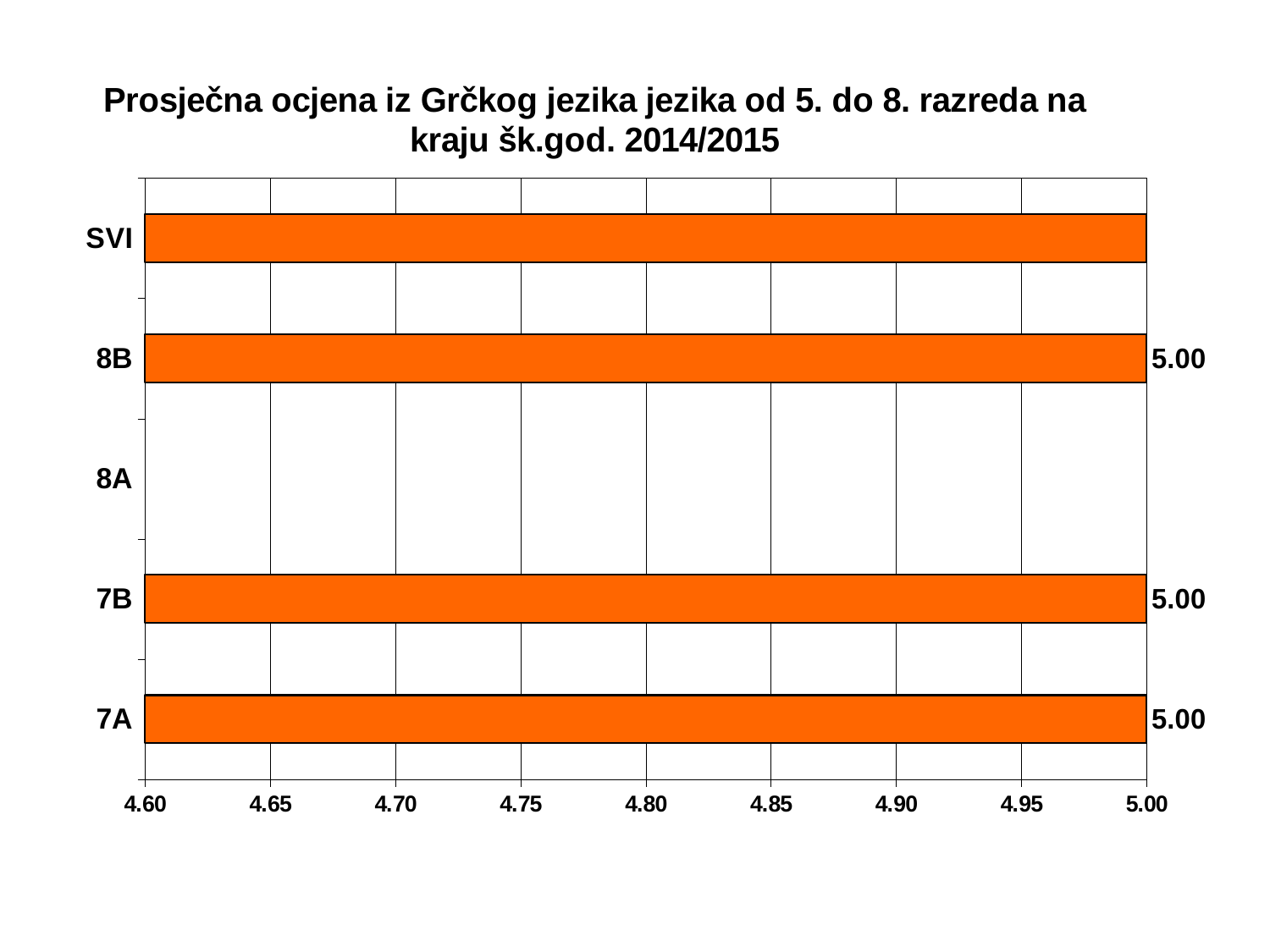
What is the lowest value shown on the horizontal axis? 4.60 How many categories are shown on the vertical axis? 5 What kind of chart is shown on the slide? bar chart What is the value for 8B? 5.00 What is the difference between the values for 7A and 8B? 0.00 Is the value for 7B greater or less than 4.80? greater What is the value for 7B? 5.00 Which category has no bar plotted? 8A Is the value for SVI greater or less than 4.90? greater What is the value for 7A? 5.00